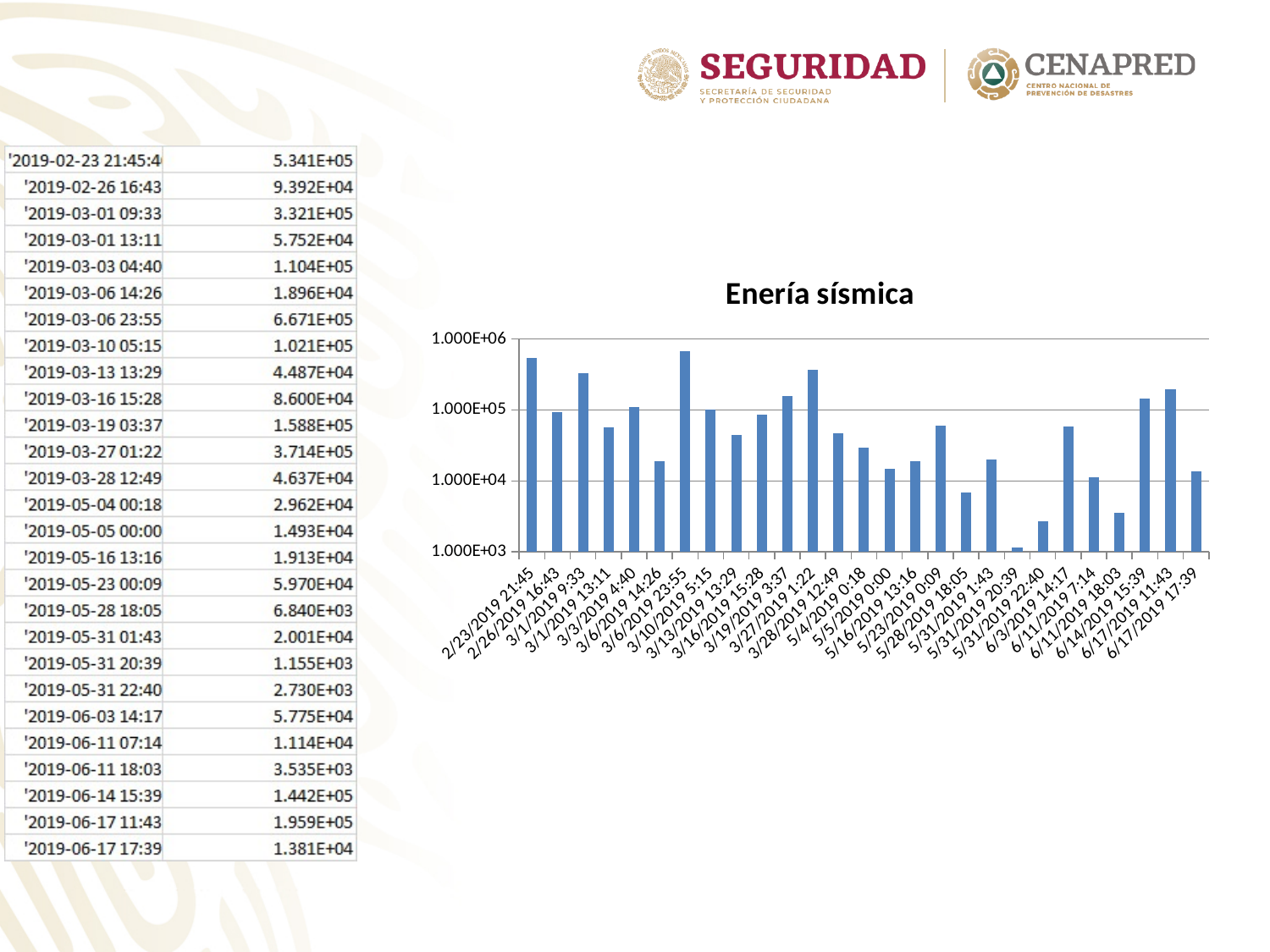
What is the seismic energy value for 3/6/2019 23:55 as listed in the table? 6.671E+05 Which date and time has the highest bar in the "Enería sísmica" chart? 3/6/2019 23:55 In the "Enería sísmica" chart, which is larger: the value for 2/23/2019 21:45 or the value for 2/26/2019 16:43? 2/23/2019 21:45 How many bars are plotted in the "Enería sísmica" chart? 27 In the "Enería sísmica" chart, is the value for 5/28/2019 18:05 greater or less than 1.000E+04? less What is the seismic energy value for 2/23/2019 21:45 as listed in the table? 5.341E+05 What type of chart is shown under the title "Enería sísmica"? bar chart In the "Enería sísmica" chart, is the value for 2/23/2019 21:45 greater or less than 1.000E+05? greater What is the seismic energy value for 6/17/2019 11:43 as listed in the table? 1.959E+05 What is the title of the chart on the slide? Enería sísmica Which date and time has the lowest bar in the "Enería sísmica" chart? 5/31/2019 20:39 What is the seismic energy value for 5/31/2019 20:39 as listed in the table? 1.155E+03